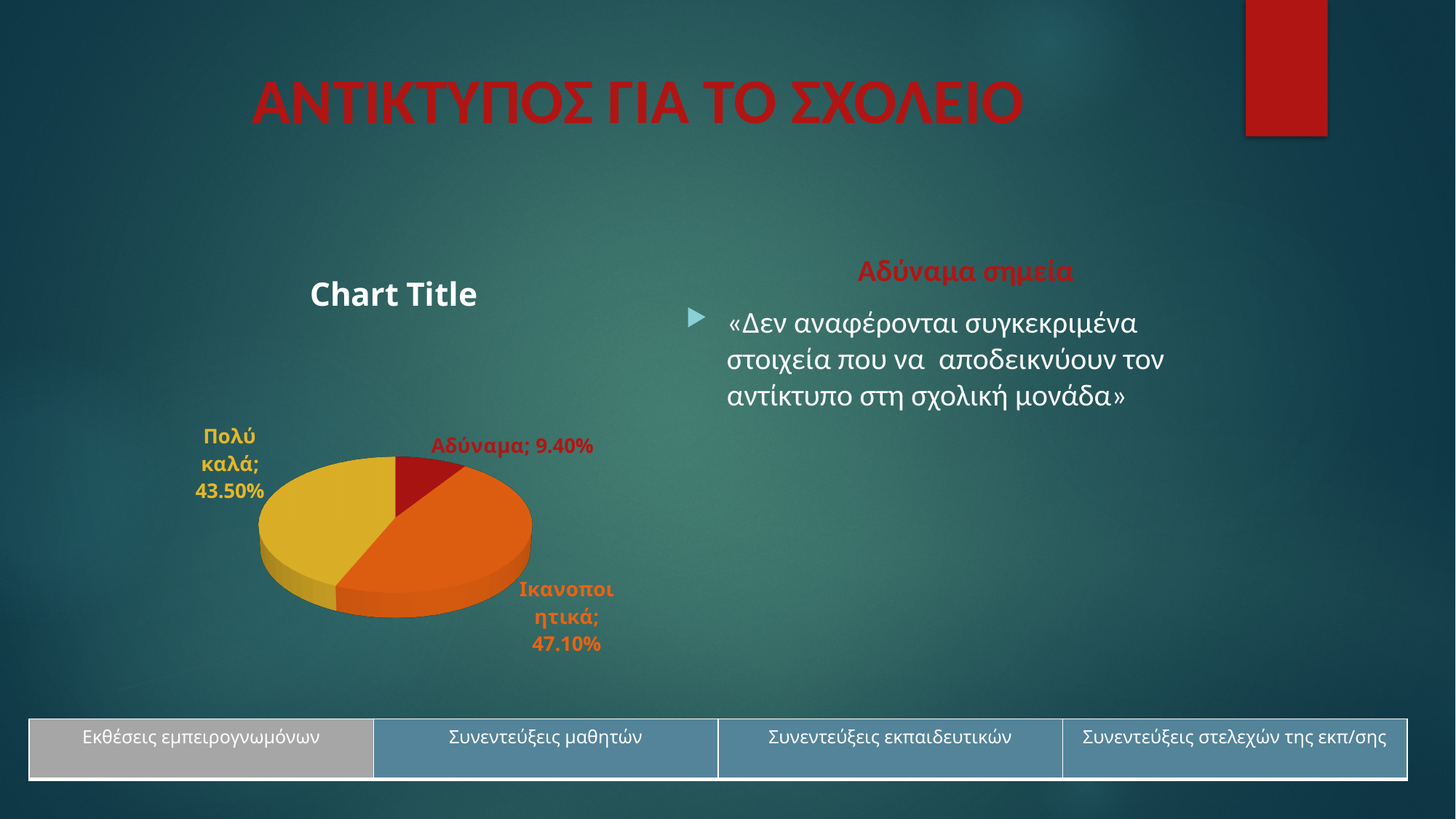
How many slices does the pie chart have? 3 What is the value for Αδύναμα in the pie chart? 9.40% What is the value for Πολύ καλά in the pie chart? 43.50% What is the difference between the values for Πολύ καλά and Αδύναμα? 34.10% Which category has the smallest slice in the pie chart? Αδύναμα What is the title of the chart? Chart Title What colour is the Αδύναμα slice in the pie chart? dark red What is the difference between the values for Ικανοποιητικά and Πολύ καλά? 3.60% What is the value for Ικανοποιητικά in the pie chart? 47.10% Which is larger, the value for Πολύ καλά or the value for Αδύναμα? Πολύ καλά Which category has the largest slice in the pie chart? Ικανοποιητικά What type of chart is shown on the slide? pie chart